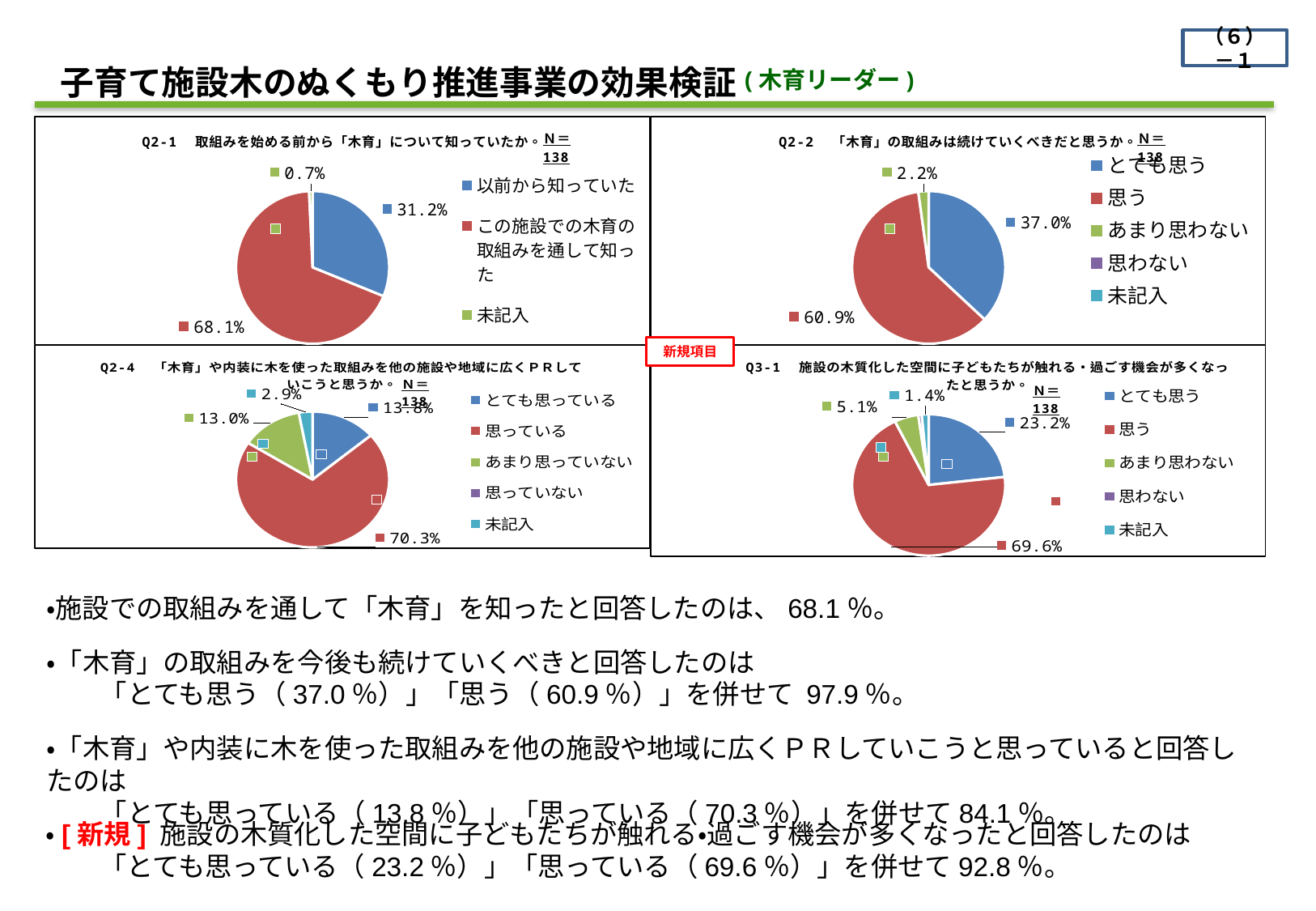
In the Q2-2 chart, which response has the largest share? 思う In the Q2-4 chart (PRしていこうと思うか), what percentage answered 「思っている」? 70.3% In the Q2-4 chart, which is larger: the share for 「とても思っている」 or the share for 「あまり思っていない」? とても思っている In the Q2-2 chart (「木育」の取組みは続けていくべきだと思うか), what percentage answered 「とても思う」? 37.0% In the Q2-4 chart, what percentage is labelled 「未記入」? 2.9% In the Q2-2 chart, what percentage answered 「あまり思わない」? 2.2% In the Q2-1 chart (取組みを始める前から「木育」について知っていたか), what percentage of respondents answered 「この施設での木育の取組みを通して知った」? 68.1% In the Q2-1 chart, what is the difference between the 「この施設での木育の取組みを通して知った」 share and the 「以前から知っていた」 share? 36.9% In the Q2-1 chart, what percentage answered 「以前から知っていた」? 31.2% What type of chart is used for Q3-1? Pie chart In the Q3-1 chart (子どもたちが触れる・過ごす機会が多くなったと思うか), what percentage answered 「とても思う」? 23.2% In the Q3-1 chart, how many entries does the legend list? 5